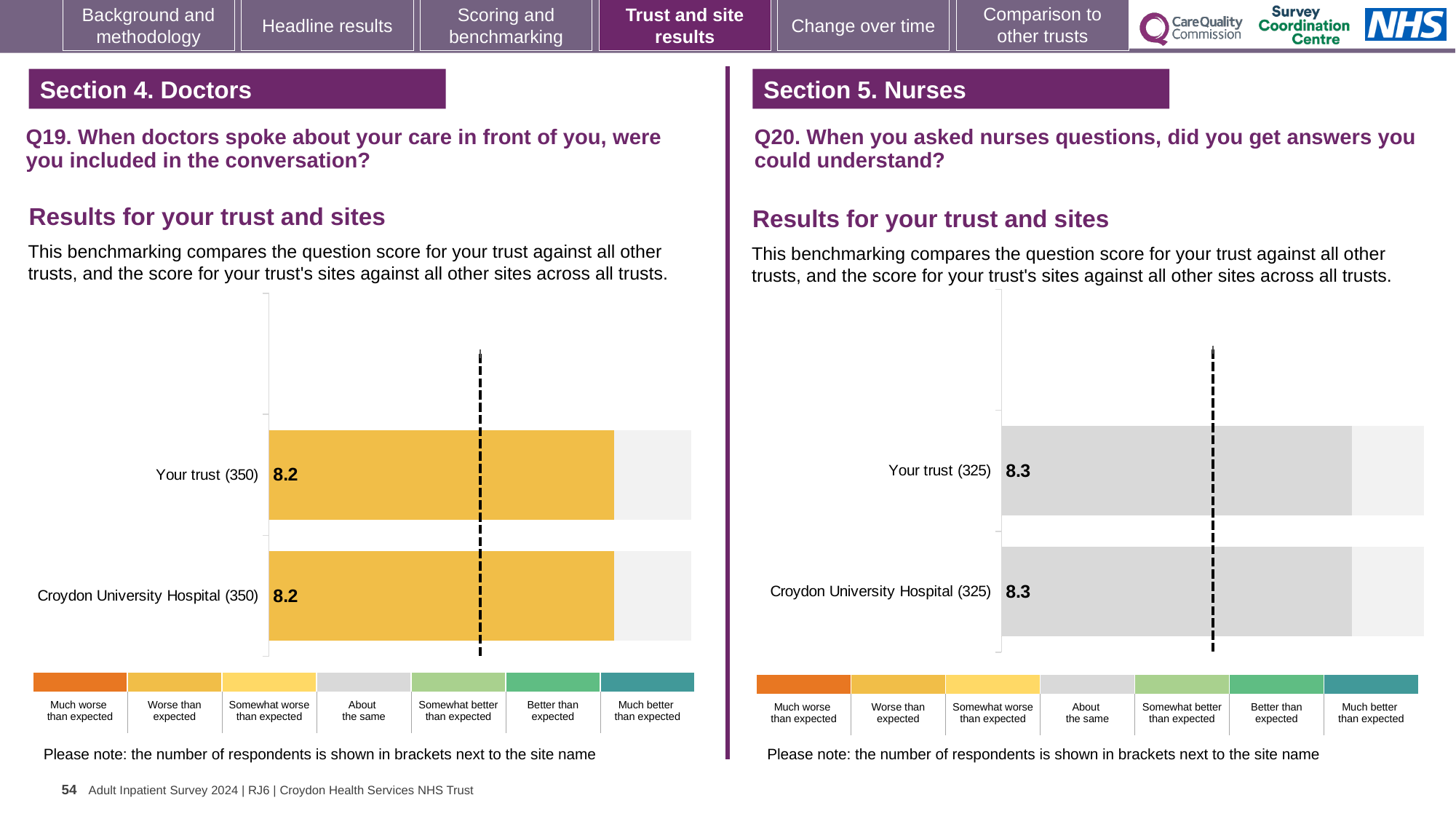
On the Q19 chart (Section 4. Doctors), which benchmark category does the colour of the bars correspond to in the key below the chart? Worse than expected On the Q20 chart (Section 5. Nurses), which benchmark category does the colour of the bars correspond to in the key below the chart? About the same On the Q19 chart (Section 4. Doctors), what is the score for Your trust? 8.2 On the Q19 chart (Section 4. Doctors), how many respondents are shown in brackets for Your trust? 350 On the Q20 chart (Section 5. Nurses), how many respondents are shown in brackets for Croydon University Hospital? 325 On the Q20 chart (Section 5. Nurses), what is the score for Your trust? 8.3 On the Q19 chart (Section 4. Doctors), what is the difference between the score for Your trust and the score for Croydon University Hospital? 0 What kind of chart is used on the Q19 chart (Section 4. Doctors)? Bar chart On the Q19 chart (Section 4. Doctors), what is the score for Croydon University Hospital? 8.2 On the Q20 chart (Section 5. Nurses), how many bars are plotted? 2 Is the score for Your trust on the Q20 chart (Section 5. Nurses) higher or lower than the score for Your trust on the Q19 chart (Section 4. Doctors)? Higher On the Q20 chart (Section 5. Nurses), what is the score for Croydon University Hospital? 8.3